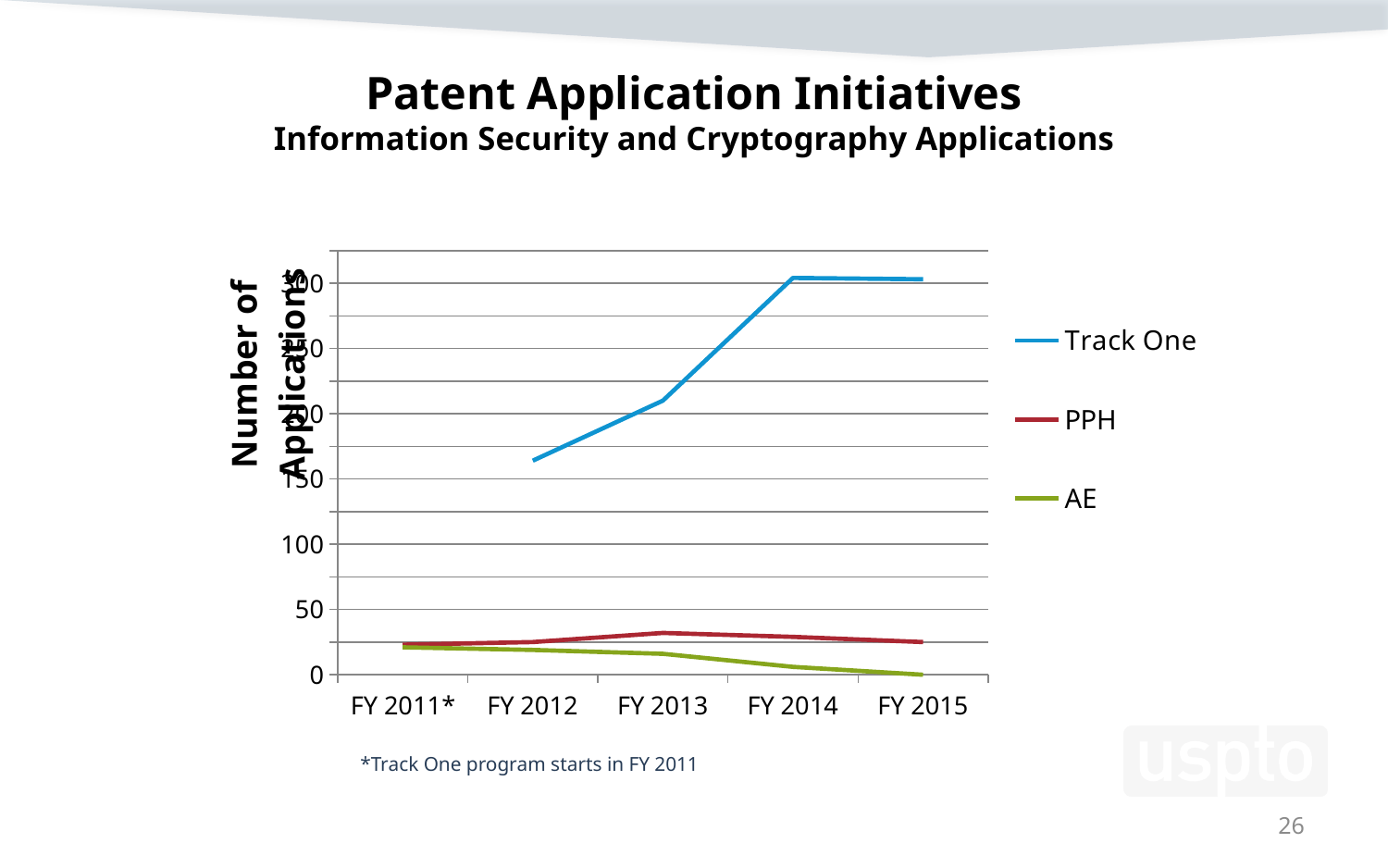
In which fiscal year is the Track One value lowest? FY 2012 Which series has the lowest value in FY 2015? AE How many series does the legend list? 3 Is the Track One value for FY 2014 greater or less than 250? greater Does the AE series rise or fall from FY 2011* to FY 2015? fall Is the PPH value for FY 2013 greater or less than 50? less What kind of chart is shown on the slide? line chart How many fiscal years are shown on the x axis? 5 In which fiscal year is the AE value lowest? FY 2015 Is the Track One value for FY 2012 greater or less than 150? greater Which series has the highest value in FY 2015? Track One Which is larger in FY 2015, PPH or AE? PPH